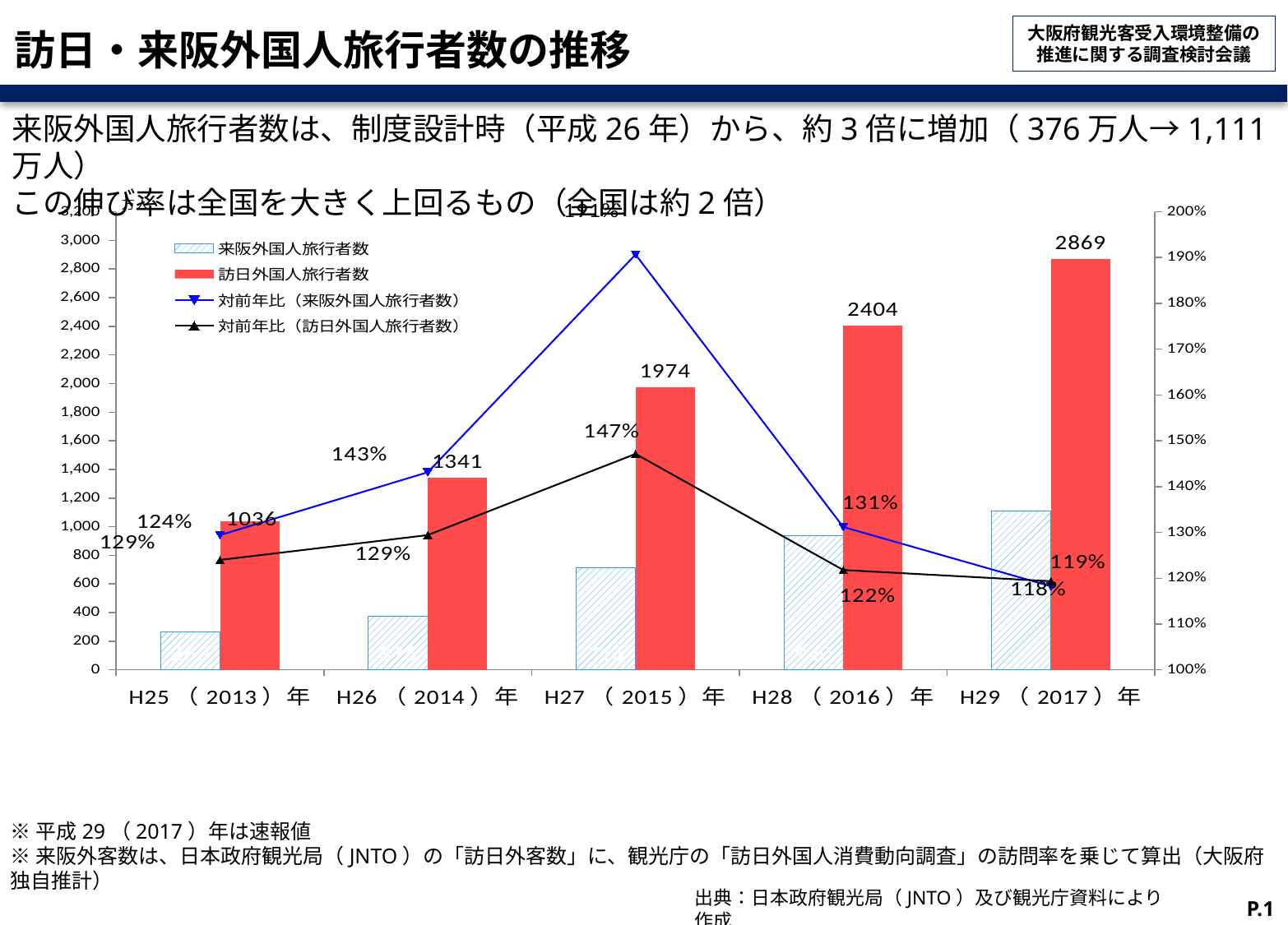
Which year has the highest 訪日外国人旅行者数 bar? H29（2017）年 Is the 来阪外国人旅行者数 bar for H29（2017）年 greater or less than 1,000? greater What is the value of 訪日外国人旅行者数 for H29（2017）年? 2869 What is the 対前年比（訪日外国人旅行者数） value for H27（2015）年? 147% How many years are shown on the x axis? 5 Do the 訪日外国人旅行者数 bars rise or fall from H25（2013）年 to H29（2017）年? rise What is the 対前年比（来阪外国人旅行者数） value for H26（2014）年? 143% What is the difference between the 訪日外国人旅行者数 values for H29（2017）年 and H28（2016）年? 465 What is the value of 訪日外国人旅行者数 for H27（2015）年? 1974 Is the 来阪外国人旅行者数 bar for H25（2013）年 greater or less than 400? less How many series does the legend list? 4 Which year has the lowest 訪日外国人旅行者数 bar? H25（2013）年